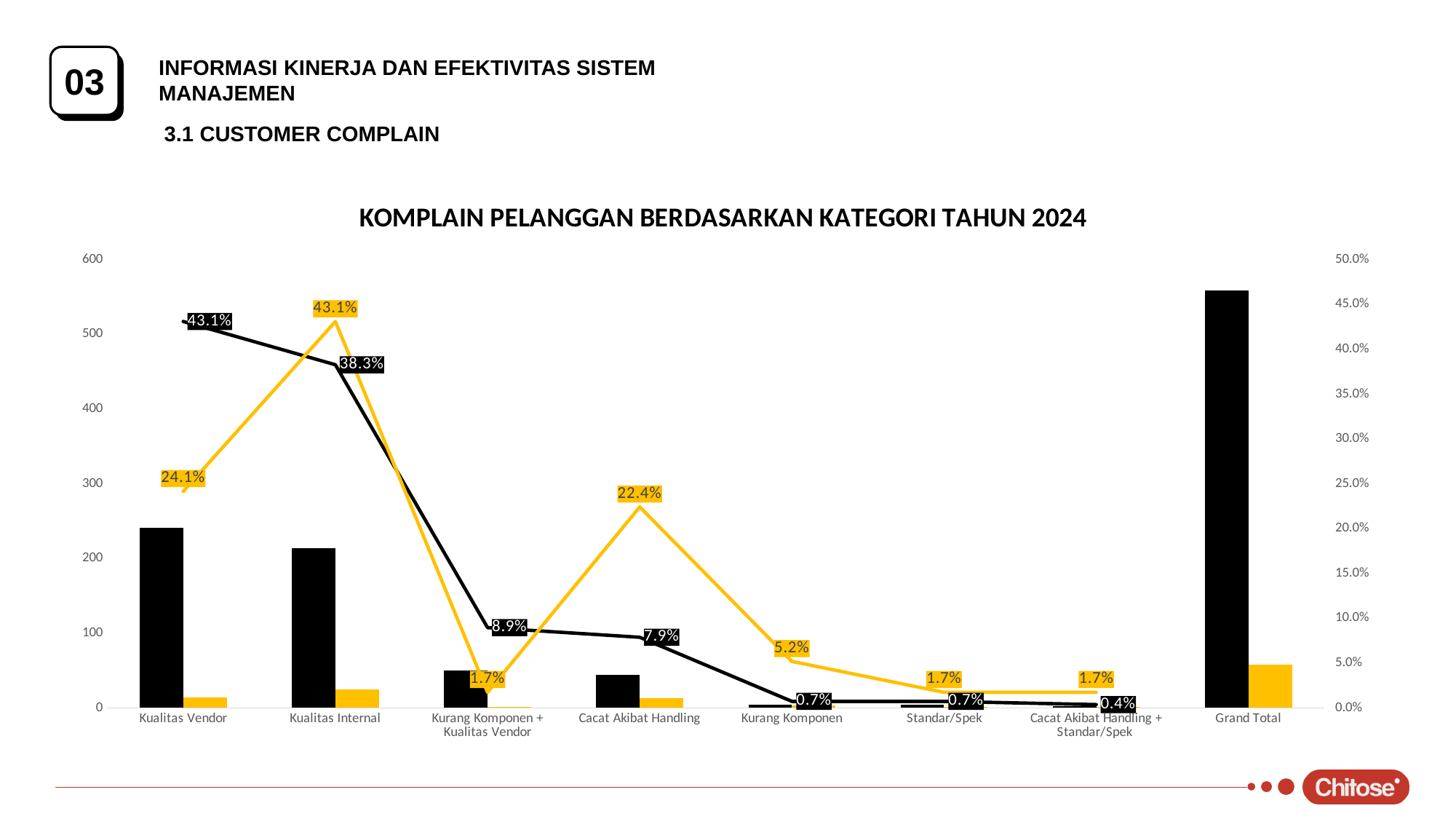
Is the black bar for Grand Total greater or less than 500 on the left axis? greater Which category has the highest value on the yellow line? Kualitas Internal What percentage does the black line show for Kualitas Vendor? 43.1% What is the title of the chart? KOMPLAIN PELANGGAN BERDASARKAN KATEGORI TAHUN 2024 What percentage does the black line show for Kualitas Internal? 38.3% What kind of chart is shown on the slide? A combination chart of bars and lines What is the difference between the black line values for Kualitas Vendor and Kualitas Internal? 4.8 percentage points What percentage does the yellow line show for Cacat Akibat Handling? 22.4% What percentage does the yellow line show for Kurang Komponen? 5.2% Which category has the lowest value on the black line? Cacat Akibat Handling + Standar/Spek How many categories are shown along the x axis of the chart? 8 On the yellow line, which is larger: the value for Kualitas Vendor or the value for Cacat Akibat Handling? Kualitas Vendor